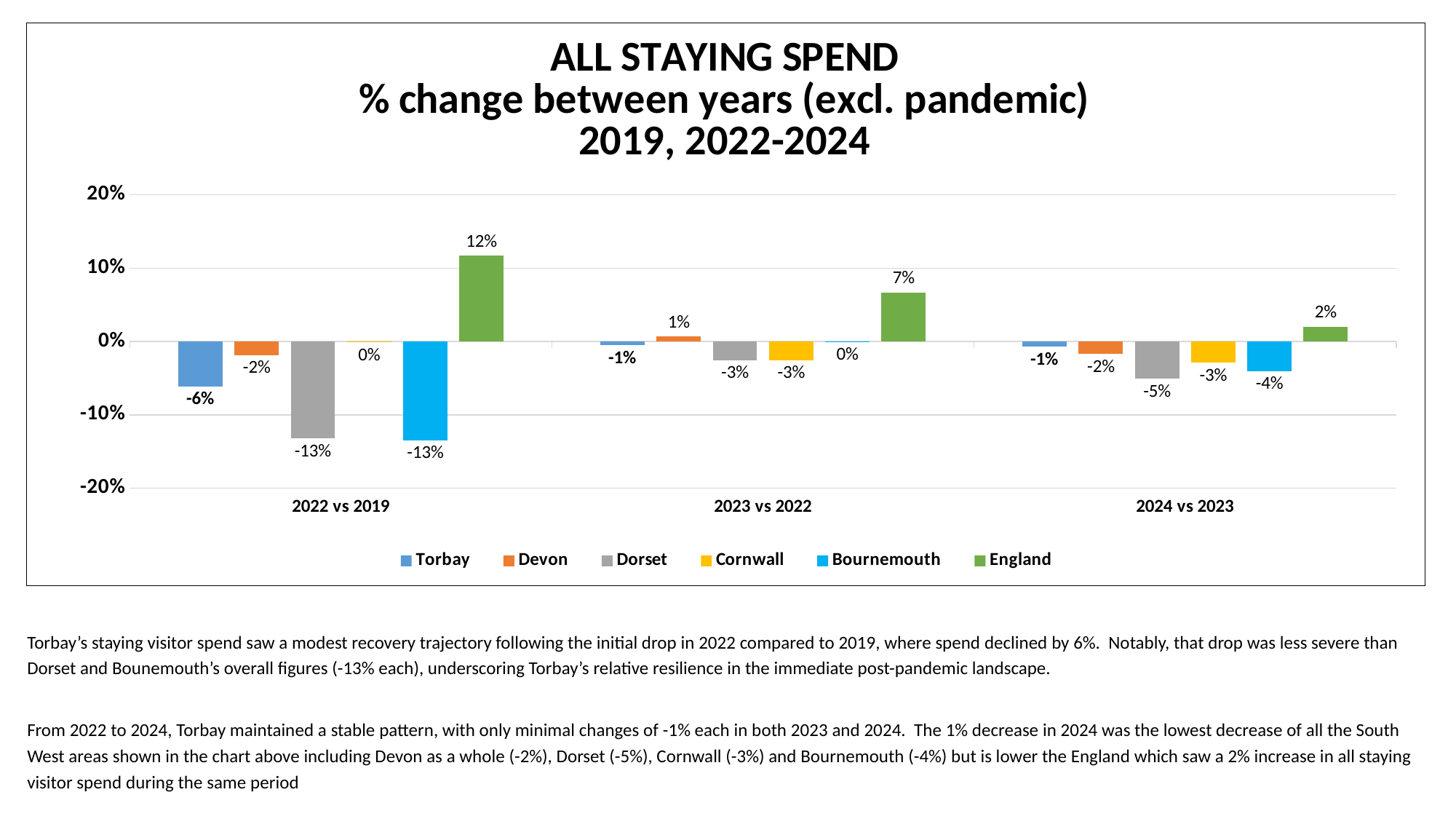
What is the difference between England's value and Torbay's value in the 2024 vs 2023 group? 3 percentage points How many series does the legend list? 6 What is the value for Dorset in the 2024 vs 2023 group? -5% What is the value for Torbay in the 2022 vs 2019 group? -6% Which series has the highest value in the 2023 vs 2022 group? England What is the value for Bournemouth in the 2024 vs 2023 group? -4% What is the value for England in the 2022 vs 2019 group? 12% In the 2022 vs 2019 group, which is larger, the value for Devon or the value for Dorset? Devon How many category groups are shown on the x axis? 3 Do England's values rise or fall across the three groups from 2022 vs 2019 to 2024 vs 2023? Fall What kind of chart is shown on the slide? Bar chart Which series has the lowest value in the 2024 vs 2023 group? Dorset